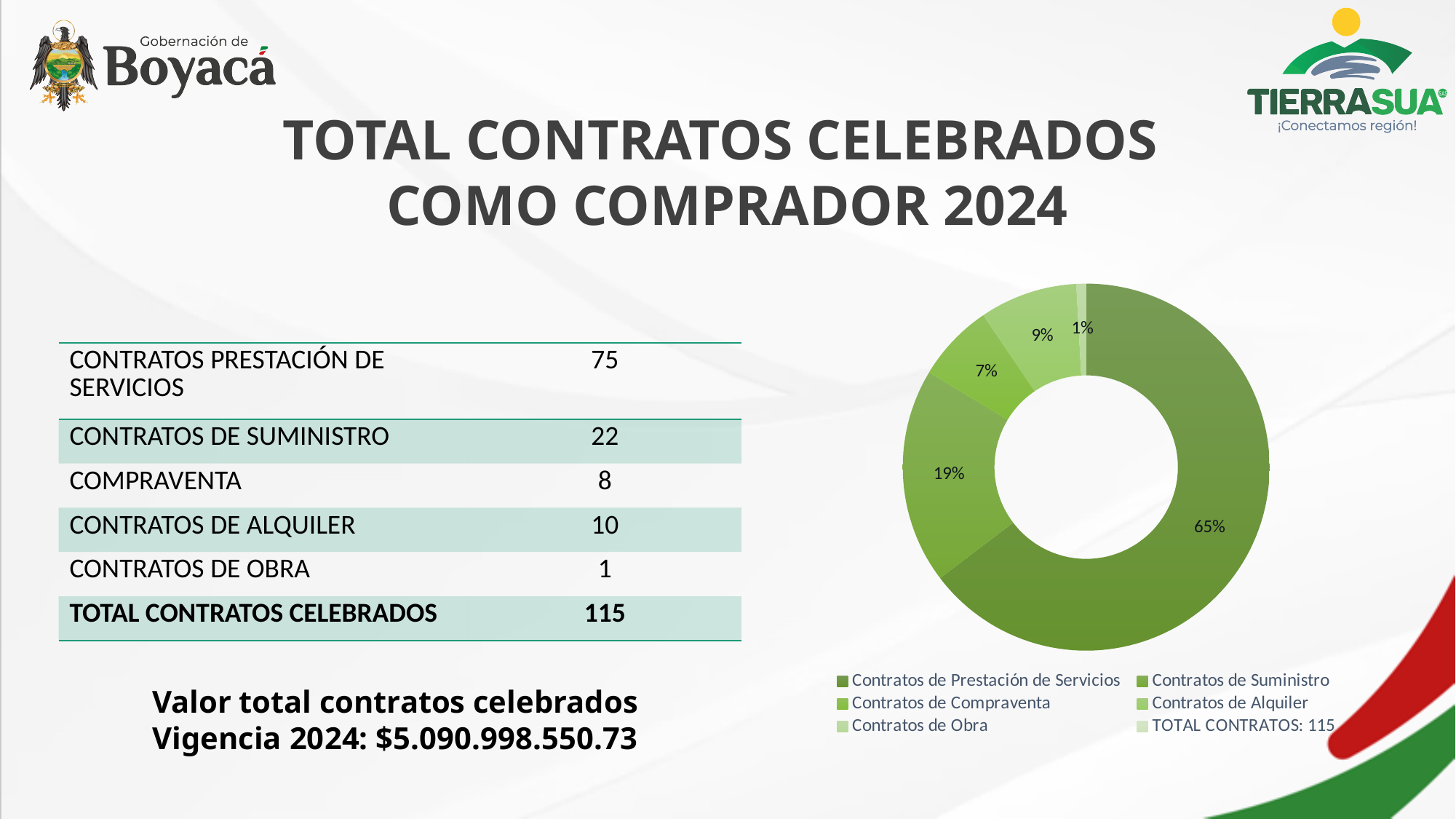
What kind of chart is shown on the slide? Doughnut (pie) chart What share of the doughnut chart does Contratos de Compraventa represent? 7% Which slice is larger in the doughnut chart: Contratos de Alquiler or Contratos de Compraventa? Contratos de Alquiler What share of the doughnut chart does Contratos de Prestación de Servicios represent? 65% What total number of contracts is stated in the last legend entry of the doughnut chart? 115 How many entries does the legend of the doughnut chart list? 6 What share of the doughnut chart does Contratos de Obra represent? 1% Which category has the largest slice in the doughnut chart? Contratos de Prestación de Servicios What is the difference in percentage points between the Contratos de Prestación de Servicios slice and the Contratos de Suministro slice? 46 percentage points Which category has the smallest slice in the doughnut chart? Contratos de Obra